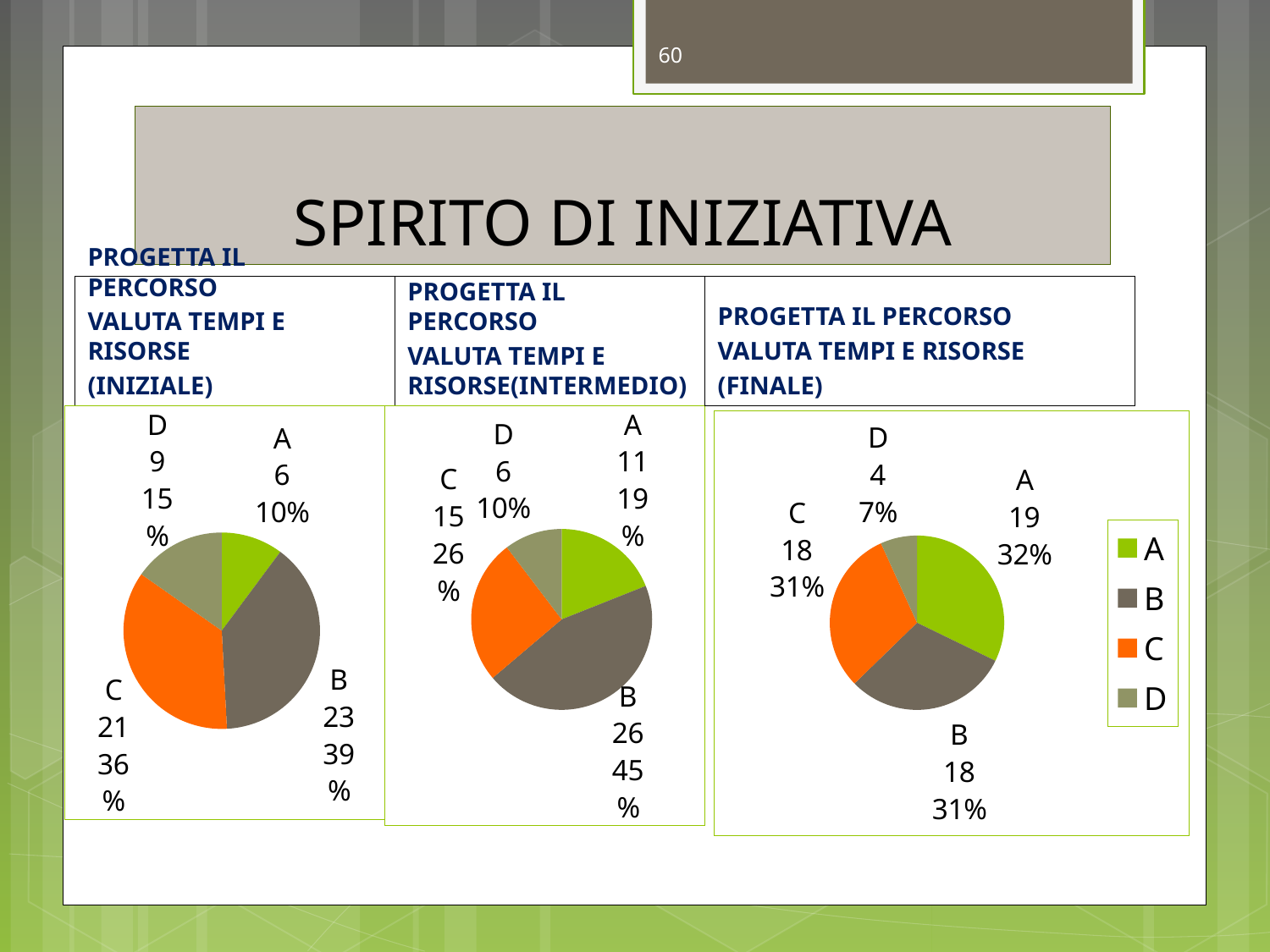
In the middle pie chart (INTERMEDIO), what is the value for category A? 11 In the middle pie chart (INTERMEDIO), which category has the largest share? B In the left pie chart (INIZIALE), which category has the smallest value? A How many categories does the right pie chart (FINALE) show? 4 In the right pie chart (FINALE), which is larger, the value for A or the value for D? A In the middle pie chart (INTERMEDIO), what is the difference between the values for B and C? 11 What type of chart is used for the INIZIALE data on the left? Pie chart In the right pie chart (FINALE), what percentage share does category D have? 7% In the left pie chart (INIZIALE), what is the value for category B? 23 How many entries does the legend next to the right pie chart list? 4 In the right pie chart (FINALE), what is the value for category A? 19 In the left pie chart (INIZIALE), what percentage share does category C have? 36%